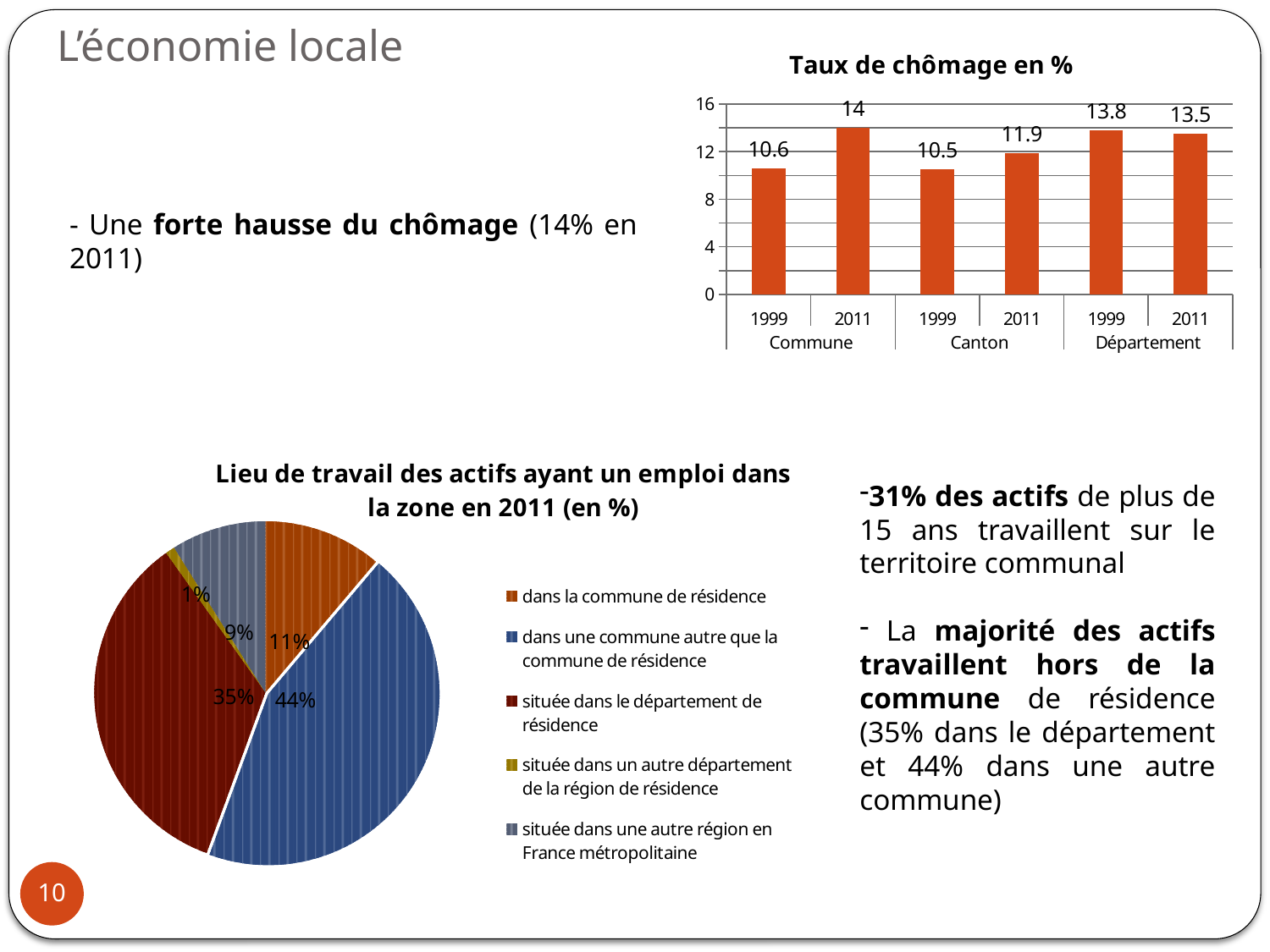
In the 'Taux de chômage en %' chart, how many bars are plotted? 6 In the 'Taux de chômage en %' chart, which bar has the highest value? Commune 2011 In the pie chart 'Lieu de travail des actifs ayant un emploi dans la zone en 2011', what share is 'dans une commune autre que la commune de résidence'? 44% In the pie chart 'Lieu de travail des actifs ayant un emploi dans la zone en 2011', which category has the smallest share? située dans un autre département de la région de résidence What type of chart is 'Taux de chômage en %'? Bar chart How many categories does the legend of the pie chart 'Lieu de travail des actifs ayant un emploi dans la zone en 2011' list? 5 In the 'Taux de chômage en %' chart, which is larger: Canton 2011 or Département 1999? Département 1999 In the 'Taux de chômage en %' chart, what is the value for Département in 2011? 13.5 In the 'Taux de chômage en %' chart, what is the unemployment rate for Commune in 2011? 14 In the 'Taux de chômage en %' chart, what is the value for Canton in 1999? 10.5 In the 'Taux de chômage en %' chart, what is the difference between the Commune values for 2011 and 1999? 3.4 In the 'Taux de chômage en %' chart, which bar has the lowest value? Canton 1999